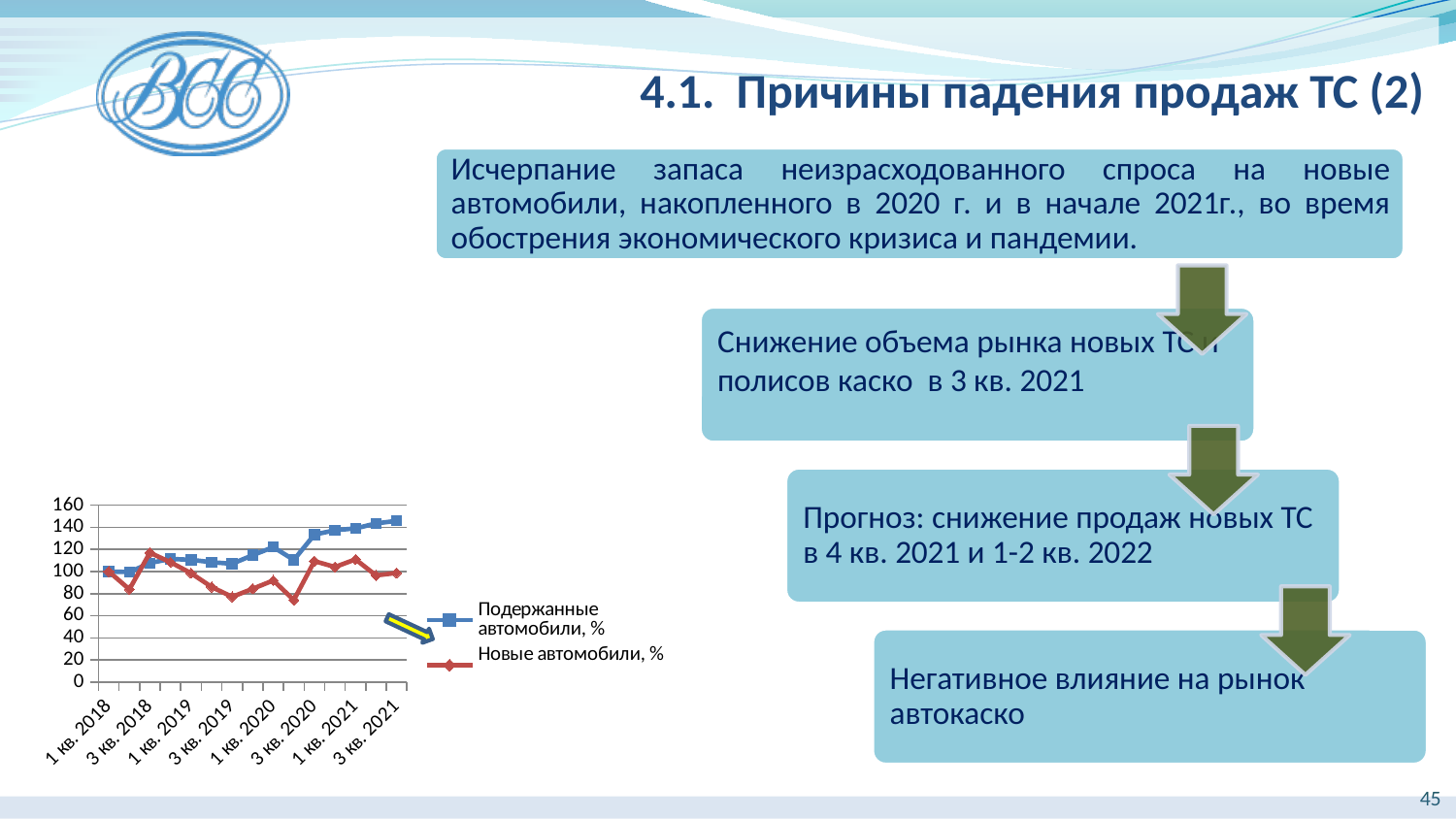
What kind of chart is shown on the slide? line chart Is the value for 'Новые автомобили, %' at 3 кв. 2021 greater or less than 120? less What is the highest value shown on the y axis of the chart? 160 Is the value for 'Новые автомобили, %' at 3 кв. 2020 greater or less than 80? greater Does the 'Подержанные автомобили, %' series generally rise or fall from 1 кв. 2018 to 3 кв. 2021? rise At 3 кв. 2021, which series has the larger value: 'Подержанные автомобили, %' or 'Новые автомобили, %'? Подержанные автомобили, % What are the two series named in the chart legend? Подержанные автомобили, % and Новые автомобили, % At which x-axis category does the 'Подержанные автомобили, %' series reach its highest value? 3 кв. 2021 Which colour is used for the series 'Новые автомобили, %'? red How many series does the chart legend list? 2 How many category labels are shown on the x axis of the chart? 8 Is the value for 'Подержанные автомобили, %' at 3 кв. 2021 greater or less than 120? greater